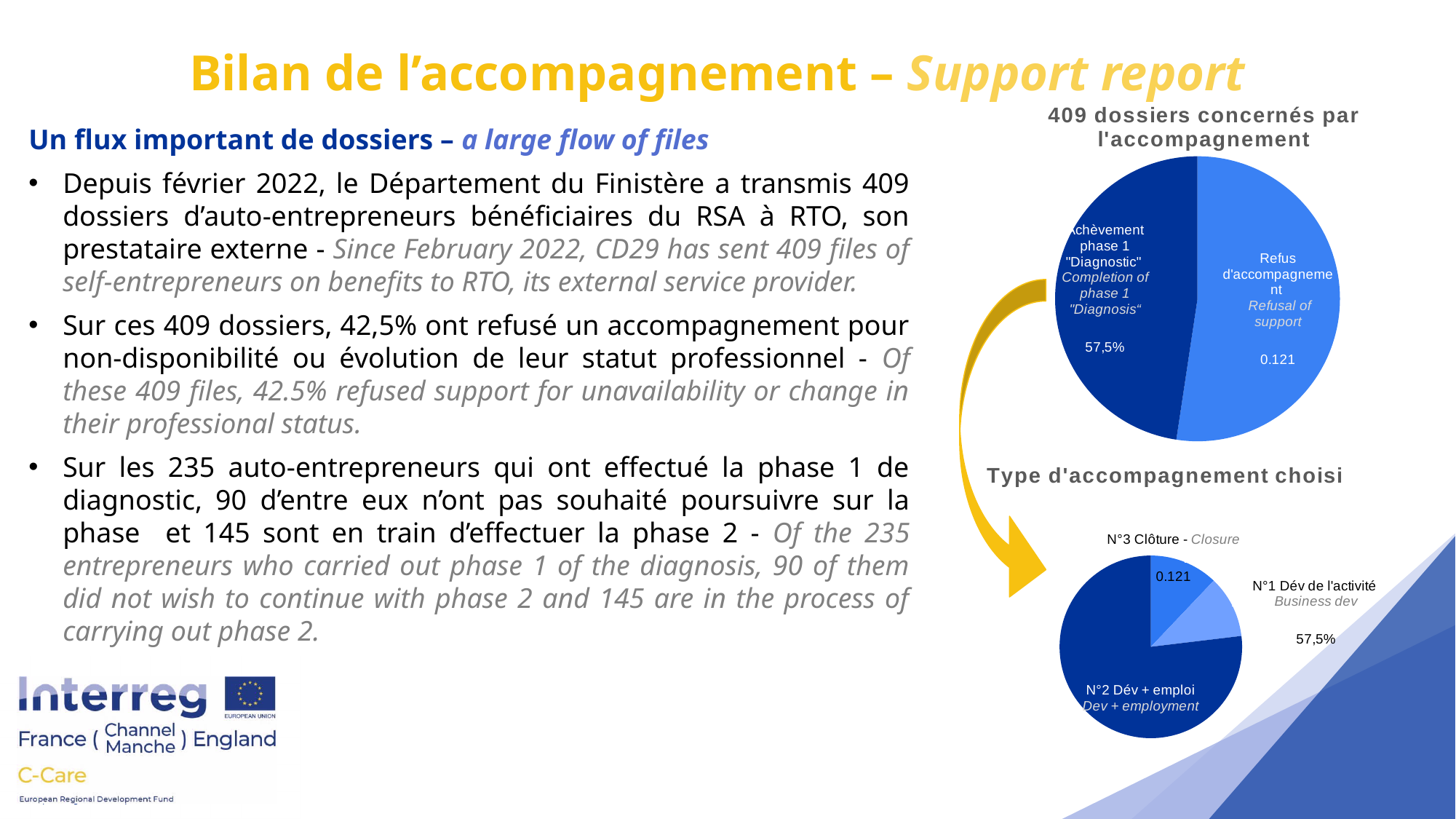
What kind of chart is the '409 dossiers concernés par l'accompagnement' chart? pie chart In the 'Type d'accompagnement choisi' chart, how many slices does the pie have? 3 In the 'Type d'accompagnement choisi' chart, what value is printed next to the 'N°3 Clôture' slice? 0.121 What is the title of the lower pie chart on the slide? Type d'accompagnement choisi In the '409 dossiers concernés par l'accompagnement' chart, what value is printed on the 'Refus d'accompagnement' slice? 0.121 In the '409 dossiers concernés par l'accompagnement' chart, which slice is larger: 'Achèvement phase 1 "Diagnostic"' or 'Refus d'accompagnement'? Achèvement phase 1 "Diagnostic" What kind of chart is the 'Type d'accompagnement choisi' chart? pie chart In the 'Type d'accompagnement choisi' chart, which slice is the largest? N°2 Dév + emploi In the '409 dossiers concernés par l'accompagnement' chart, how many slices does the pie have? 2 In the '409 dossiers concernés par l'accompagnement' chart, what value is printed on the 'Achèvement phase 1 "Diagnostic"' slice? 57,5% What is the title of the upper pie chart on the slide? 409 dossiers concernés par l'accompagnement